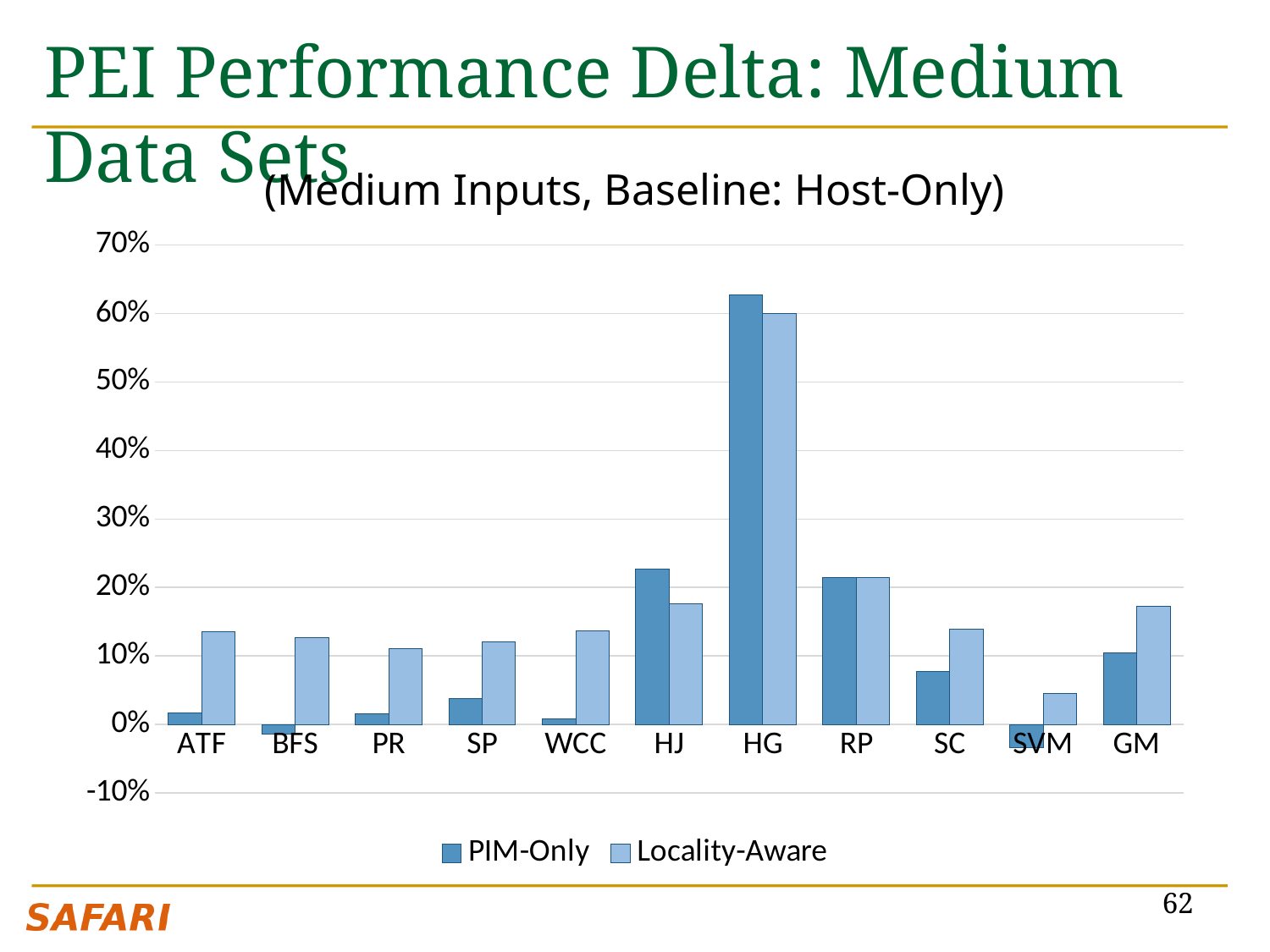
Which category has the highest PIM-Only value? HG Which category has the highest Locality-Aware value? HG Which category has the lowest Locality-Aware value? SVM What kind of chart is shown on the slide? bar chart What is the chart's title? (Medium Inputs, Baseline: Host-Only) Is the Locality-Aware value for SVM greater or less than 10%? less How many series does the legend list? 2 For HJ, which is larger: the PIM-Only value or the Locality-Aware value? PIM-Only Is the PIM-Only value for HJ greater or less than 20%? greater How many categories are shown on the x axis? 11 For ATF, which is larger: the PIM-Only value or the Locality-Aware value? Locality-Aware Is the PIM-Only value for HG greater or less than 60%? greater